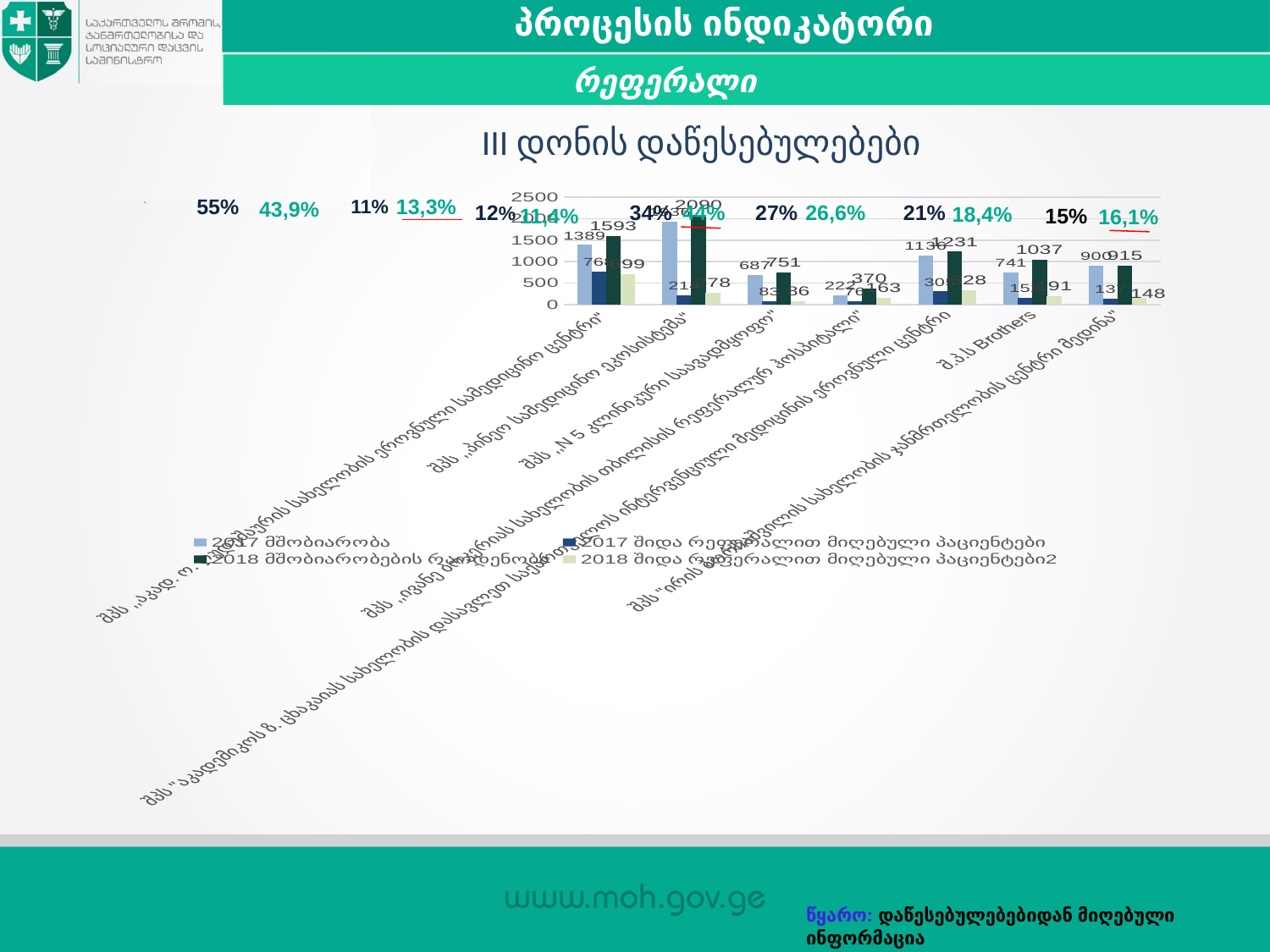
How many facility categories are plotted along the x axis? 7 What is the value of "2017 მშობიარობა" for შპს ,,N 5 კლინიკური საავადმყოფო"? 687 By how much does "2018 მშობიარობების რაოდენობა" exceed "2017 მშობიარობა" for შპს Brothers? 296 Which facility has the highest value for "2018 მშობიარობების რაოდენობა"? შპს ,,პინეო სამედიცინო ეკოსისტემა" What is the title of the chart? III დონის დაწესებულებები How many series does the chart legend list? 4 Is the "2018 მშობიარობების რაოდენობა" value for შპს Brothers greater or less than 1000? greater What is the value of "2018 მშობიარობების რაოდენობა" for შპს Brothers? 1037 What is the value of "2017 მშობიარობა" for შპს Brothers? 741 What kind of chart is shown on the slide? bar chart Which has the larger "2018 მშობიარობების რაოდენობა" value: შპს Brothers or შპს ,,N 5 კლინიკური საავადმყოფო"? შპს Brothers What is the value of "2018 მშობიარობების რაოდენობა" for შპს ,,N 5 კლინიკური საავადმყოფო"? 751